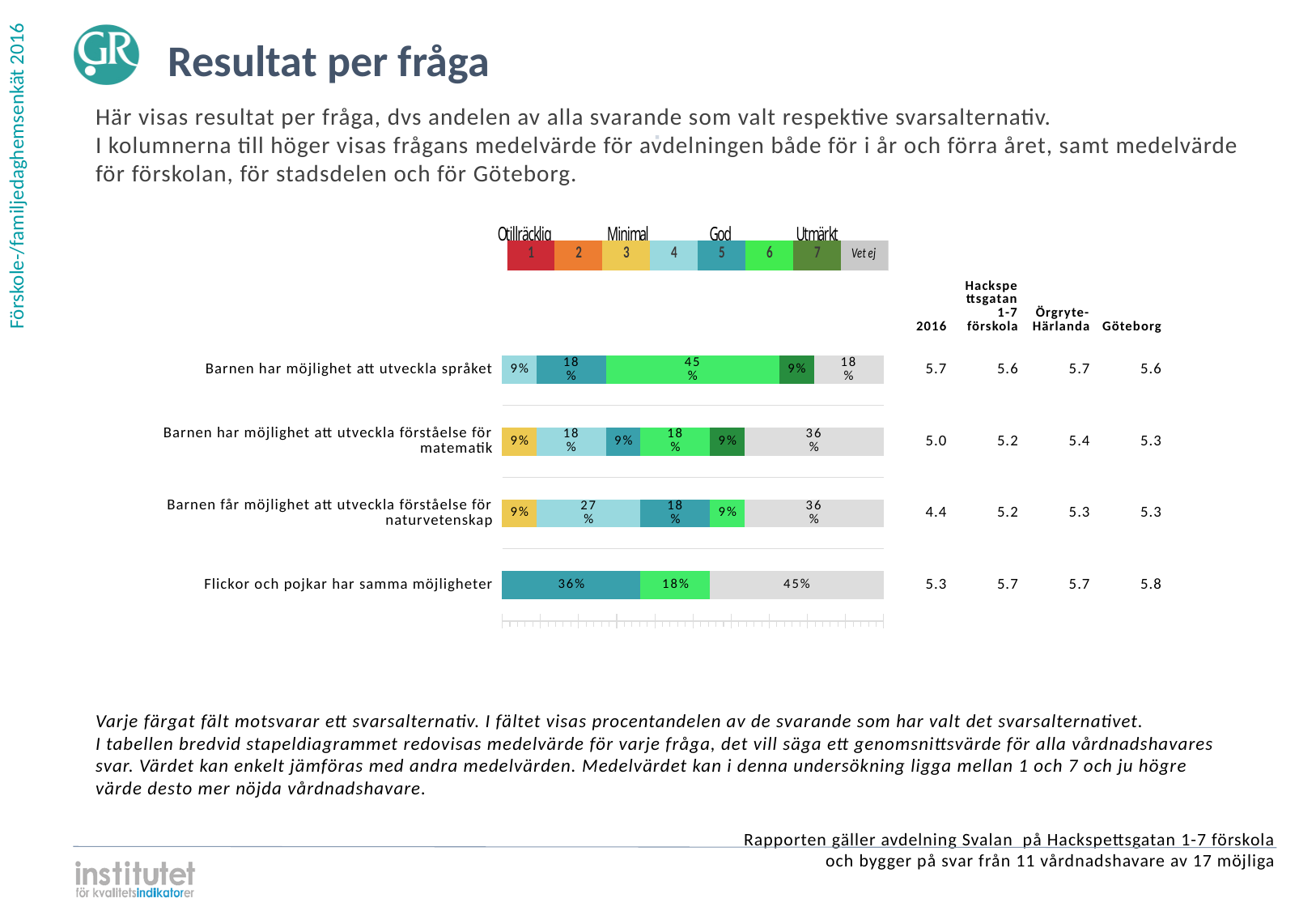
What percentage chose rating 5 (teal) for 'Flickor och pojkar har samma möjligheter'? 36% What is the 'Vet ej' share for 'Barnen har möjlighet att utveckla förståelse för matematik'? 36% What percentage chose rating 4 (light blue) for 'Barnen får möjlighet att utveckla förståelse för naturvetenskap'? 27% For 'Barnen har möjlighet att utveckla språket', how many percentage points larger is the rating 6 share than the rating 5 share? 27 percentage points How many answer options does the legend above the chart list, including 'Vet ej'? 8 What kind of chart is shown on the slide? Stacked bar chart Which question has the largest 'Vet ej' share? Flickor och pojkar har samma möjligheter What are the four text labels shown above the rating scale in the legend? Otillräcklig, Minimal, God, Utmärkt What percentage of respondents answered 'Vet ej' for 'Flickor och pojkar har samma möjligheter'? 45% How many questions (categories) are plotted in the bar chart? 4 Which has a larger 'Vet ej' share: 'Barnen har möjlighet att utveckla språket' or 'Barnen har möjlighet att utveckla förståelse för matematik'? Barnen har möjlighet att utveckla förståelse för matematik What percentage chose rating 6 (bright green) for 'Barnen har möjlighet att utveckla språket'? 45%